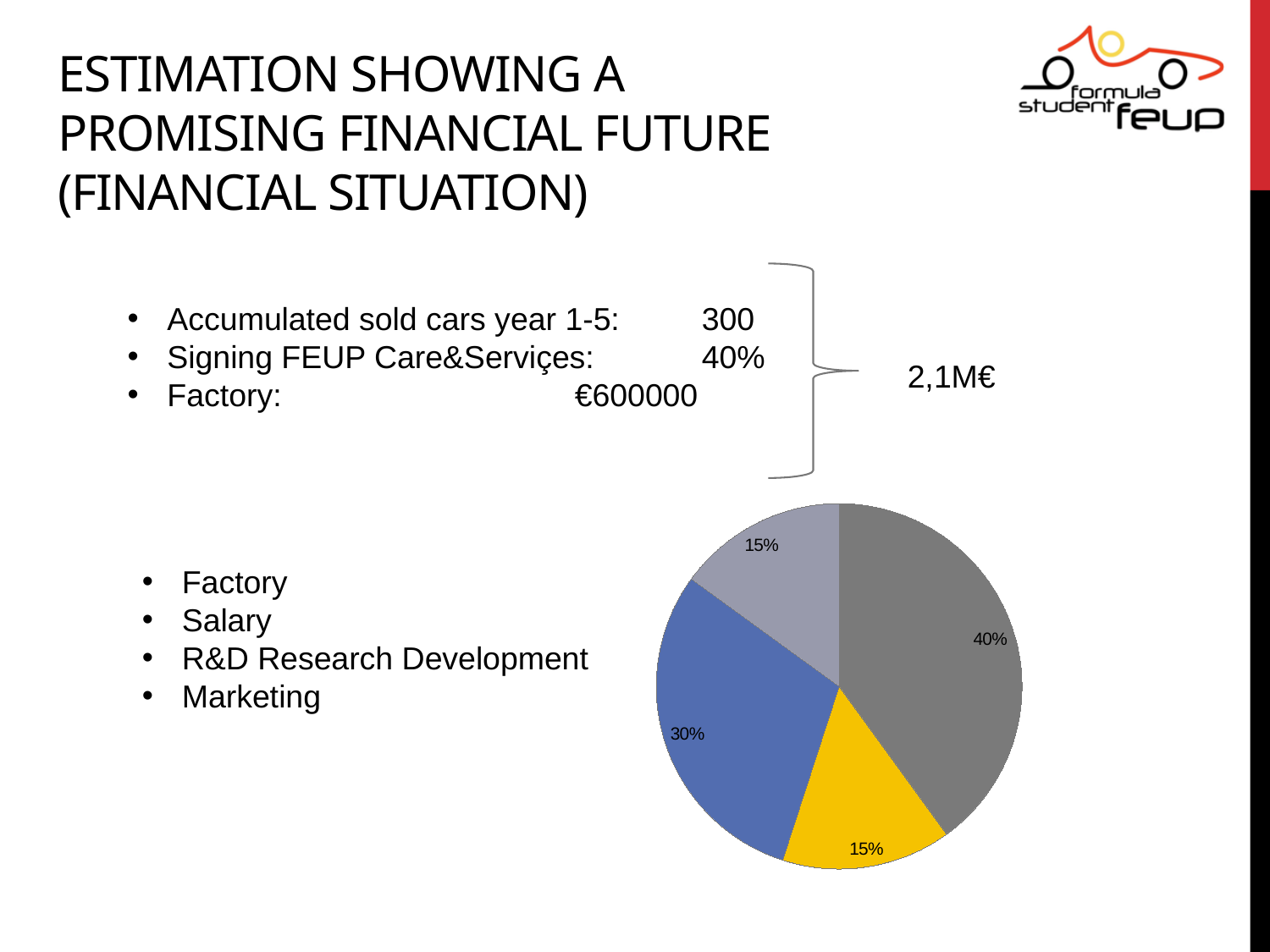
What is the difference between the dark gray slice and the blue slice of the pie chart? 10% How many slices of the pie chart are labelled 15%? 2 What is the largest percentage shown on the pie chart? 40% What is the smallest percentage shown on the pie chart? 15% What percentage is labelled on the blue slice of the pie chart? 30% What percentage is labelled on the light gray slice of the pie chart? 15% What percentage is labelled on the yellow slice of the pie chart? 15% Which slice of the pie chart is larger, the blue one or the yellow one? blue What percentage is labelled on the dark gray slice of the pie chart? 40% What kind of chart is shown on the slide? pie chart How many slices does the pie chart have? 4 What colour is the largest slice of the pie chart? dark gray